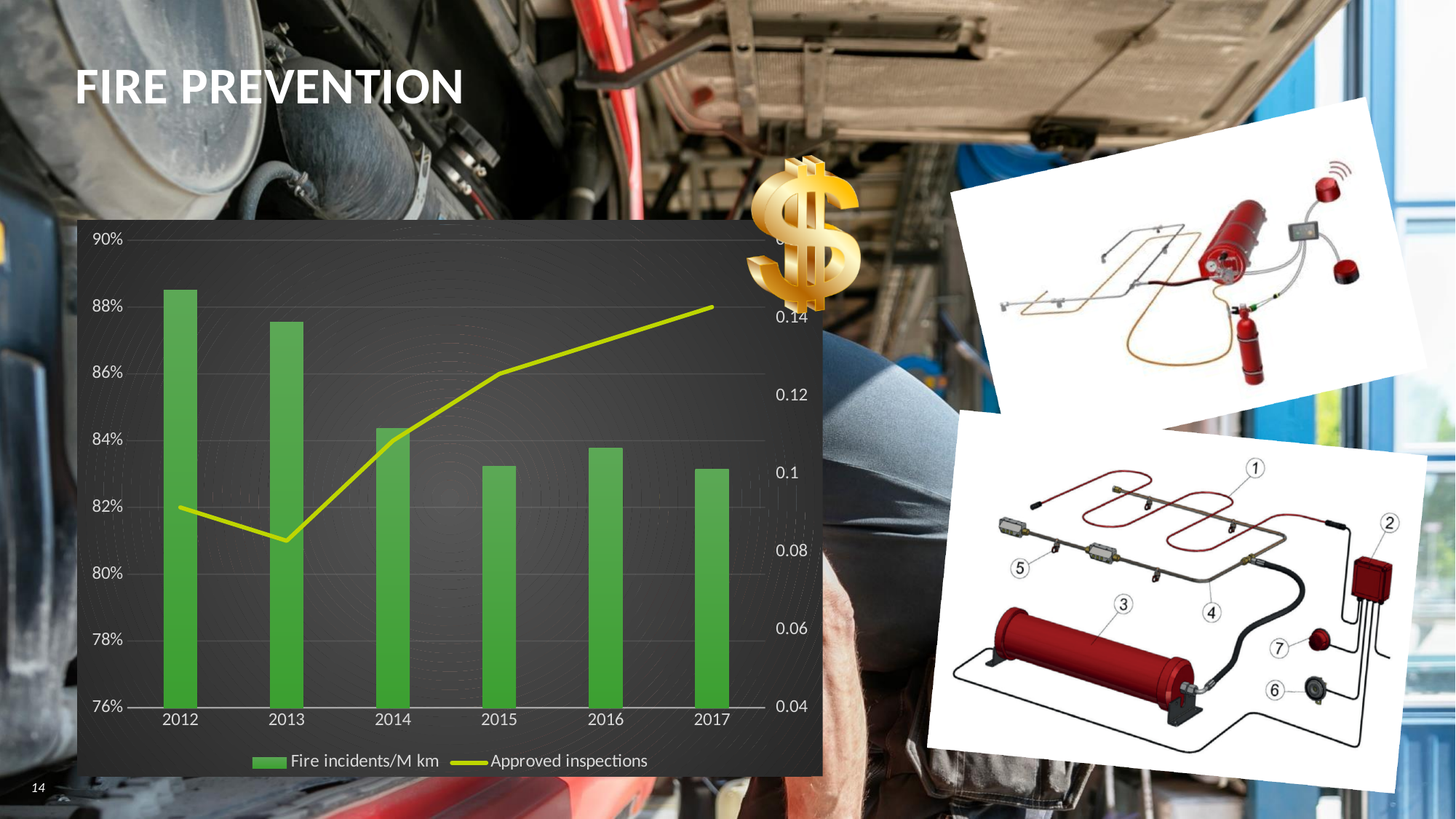
Which series is drawn as a line in the chart? Approved inspections How many years are shown on the x axis of the chart? 6 In which year is the Fire incidents/M km bar the tallest? 2012 Which series is drawn as green bars in the chart? Fire incidents/M km How many series does the chart legend list? 2 What kind of chart is shown on the slide? A combined bar and line chart Does the Approved inspections line rise or fall from 2013 to 2017? Rise In which year is the Approved inspections line at its highest point? 2017 Which year has the taller Fire incidents/M km bar, 2012 or 2016? 2012 In which year is the Approved inspections line at its lowest point? 2013 Is the Approved inspections value for 2017 greater or less than 86% on the left axis? greater Which year has the taller Fire incidents/M km bar, 2013 or 2014? 2013